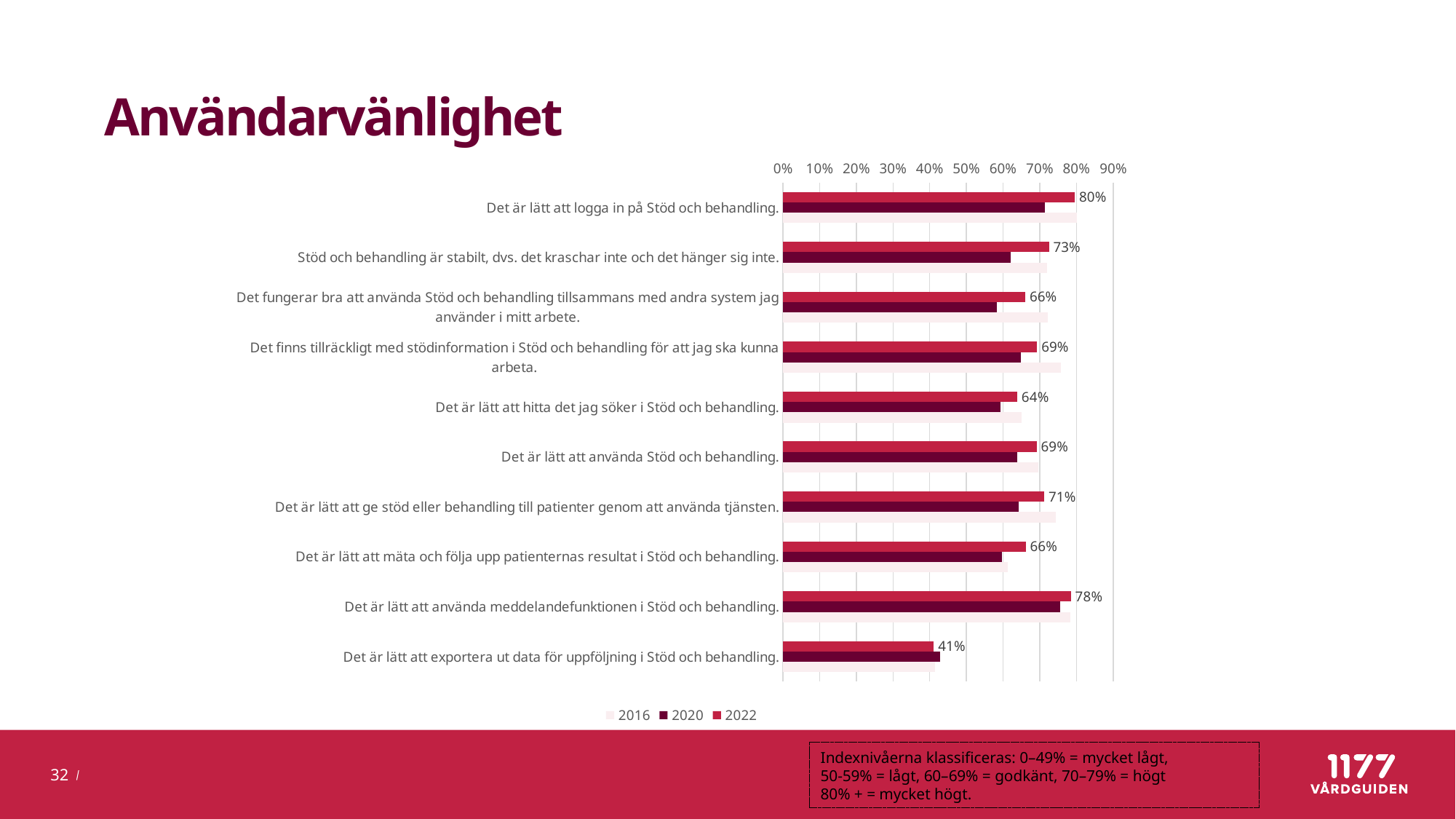
Which statement has the highest 2022 value? Det är lätt att logga in på Stöd och behandling. What is the 2022 value for "Det är lätt att använda meddelandefunktionen i Stöd och behandling."? 78% What is the 2022 value for "Det är lätt att logga in på Stöd och behandling."? 80% What kind of chart is shown on the slide? Bar chart Is the 2020 value for "Det är lätt att logga in på Stöd och behandling." greater or less than 60%? greater How many statements (categories) are shown in the chart? 10 What is the difference between the 2022 values for "Det är lätt att logga in på Stöd och behandling." and "Det är lätt att exportera ut data för uppföljning i Stöd och behandling."? 39% Which statement has the lowest 2022 value? Det är lätt att exportera ut data för uppföljning i Stöd och behandling. Which has a higher 2022 value: "Stöd och behandling är stabilt, dvs. det kraschar inte och det hänger sig inte." or "Det är lätt att hitta det jag söker i Stöd och behandling."? Stöd och behandling är stabilt, dvs. det kraschar inte och det hänger sig inte. Is the 2020 value for "Det är lätt att exportera ut data för uppföljning i Stöd och behandling." greater or less than 50%? less How many series does the legend list? 3 What is the 2022 value for "Det är lätt att exportera ut data för uppföljning i Stöd och behandling."? 41%